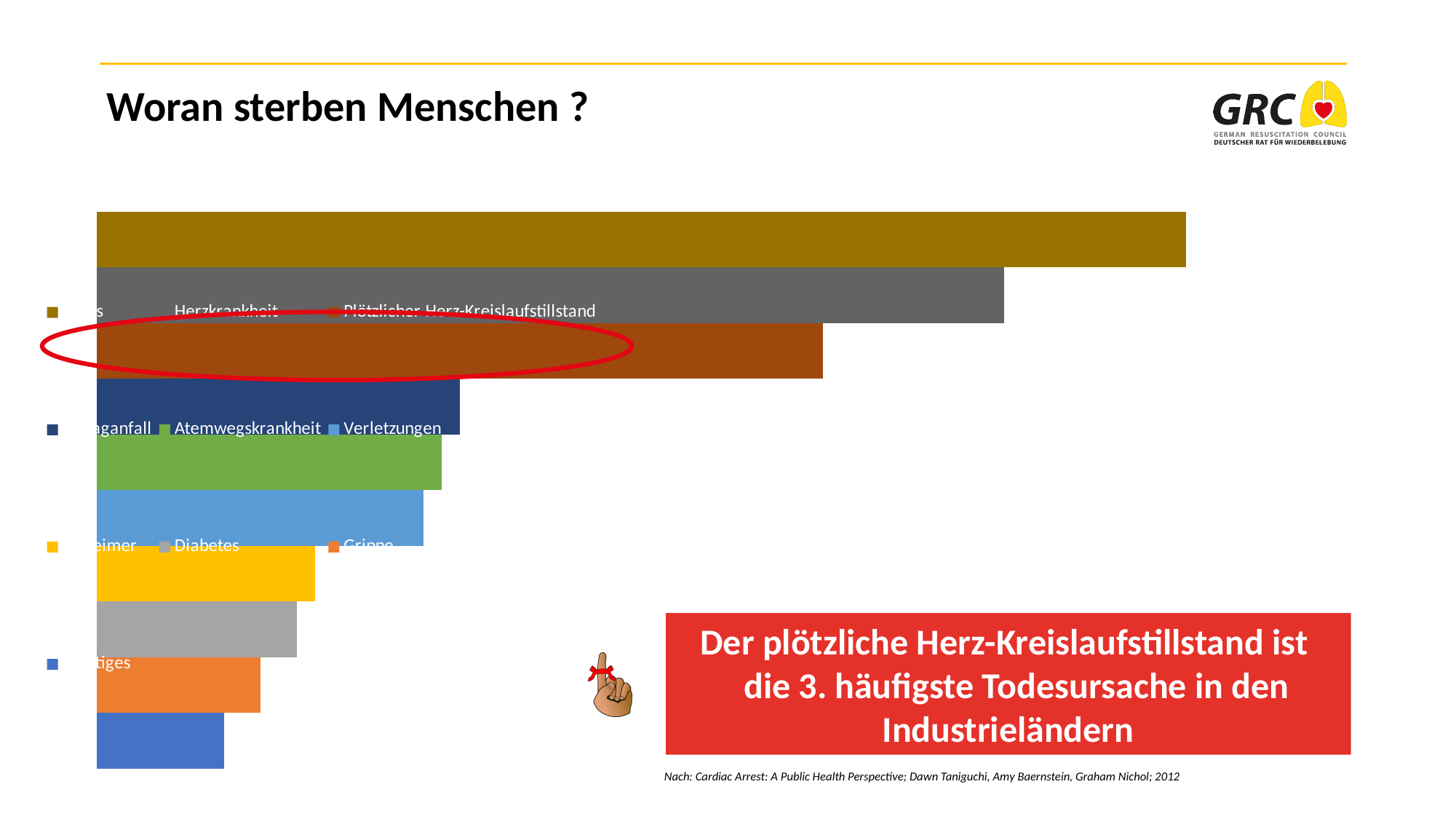
Do the bars get longer or shorter going from the top of the chart to the bottom? shorter Which category's bar is circled in red on the chart? Plötzlicher Herz-Kreislaufstillstand Which bar is longer: Herzkrankheit or Plötzlicher Herz-Kreislaufstillstand? Herzkrankheit In which position, ranked by bar length from longest to shortest, is Plötzlicher Herz-Kreislaufstillstand? third Which bar is longer: Diabetes or Verletzungen? Verletzungen How many bars does the chart contain? 10 What kind of chart is shown on the slide? bar chart Are the bars in the chart drawn horizontally or vertically? horizontally